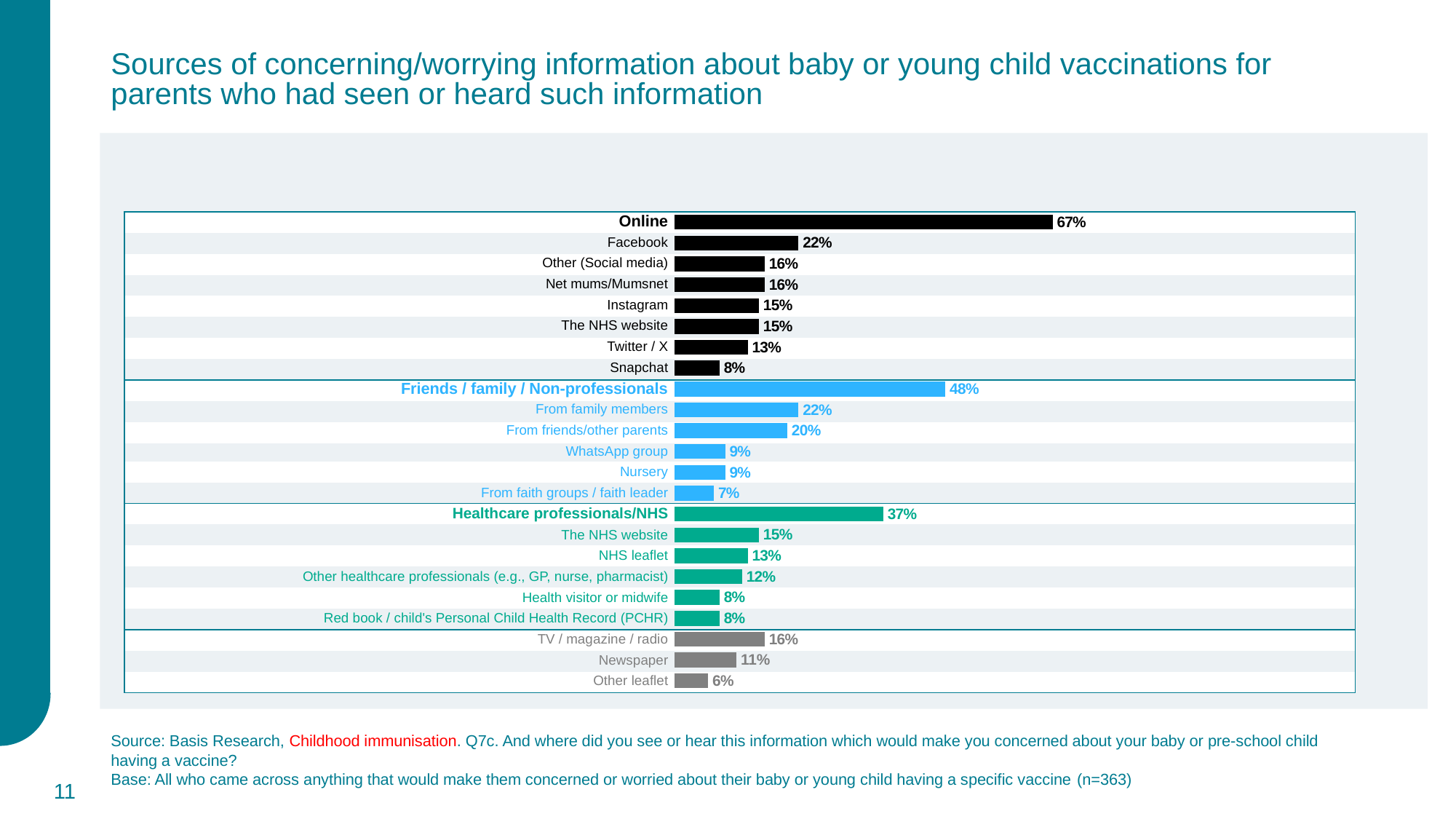
What percentage is shown for Facebook? 22% Which source has the highest percentage? Online Which is larger, Healthcare professionals/NHS or Friends / family / Non-professionals? Friends / family / Non-professionals What percentage is shown for Online? 67% What colour are the bars for the Online group of sources? Black What percentage is shown for From faith groups / faith leader? 7% How many bars are plotted in the chart? 23 What is the difference in percentage points between Online and Friends / family / Non-professionals? 19 percentage points What is the difference in percentage points between Facebook and Instagram? 7 percentage points Which source has the lowest percentage? Other leaflet What percentage is shown for Newspaper? 11% What kind of chart is shown on the slide? Bar chart